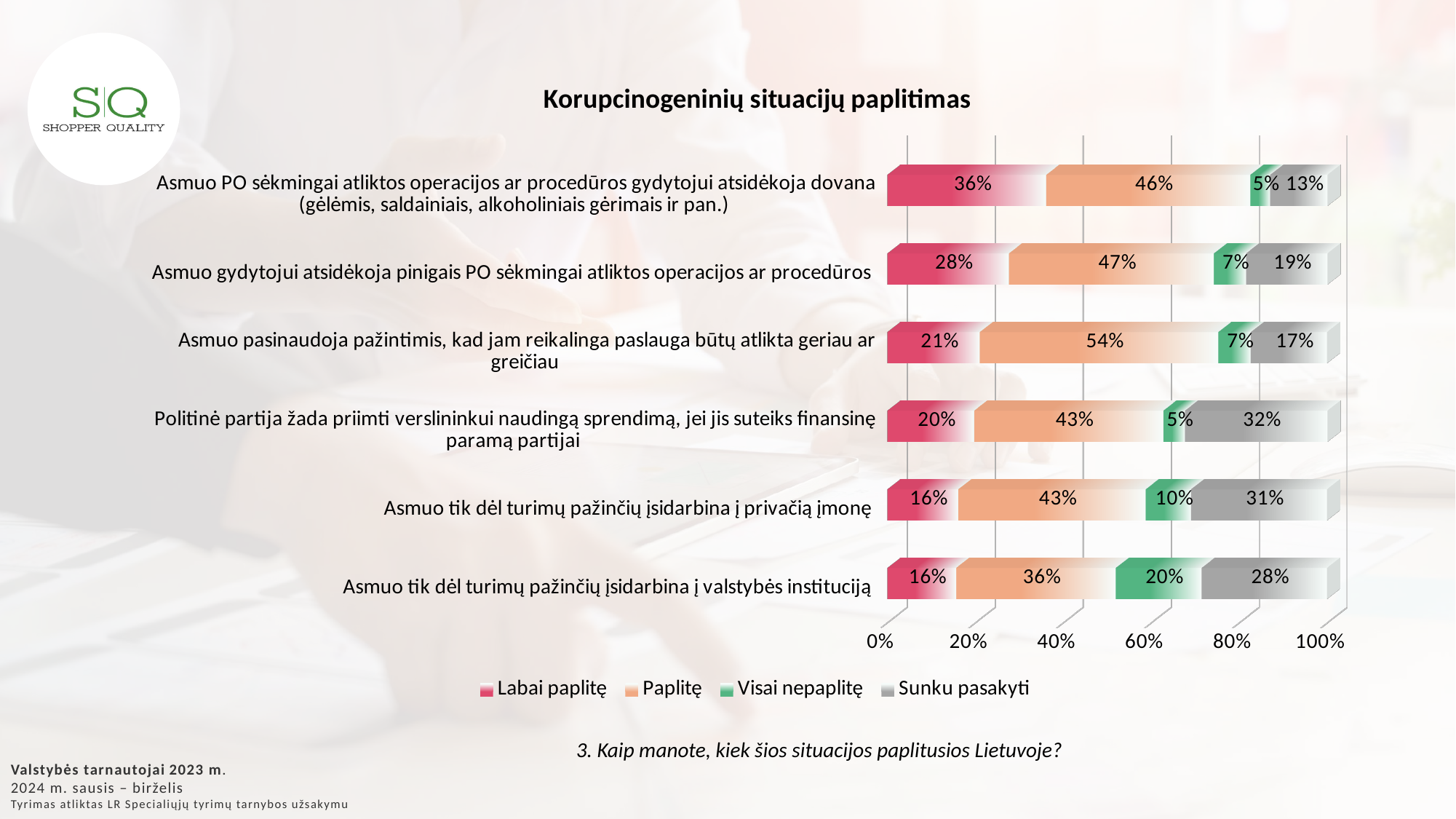
What is the combined total of 'Labai paplitę' and 'Paplitę' for 'Asmuo gydytojui atsidėkoja pinigais PO sėkmingai atliktos operacijos ar procedūros'? 75% What is the 'Sunku pasakyti' value for 'Politinė partija žada priimti verslininkui naudingą sprendimą, jei jis suteiks finansinę paramą partijai'? 32% How many series does the legend list? 4 Which category has the highest 'Visai nepaplitę' value? Asmuo tik dėl turimų pažinčių įsidarbina į valstybės instituciją What is the 'Labai paplitę' value for 'Asmuo PO sėkmingai atliktos operacijos ar procedūros gydytojui atsidėkoja dovana (gėlėmis, saldainiais, alkoholiniais gėrimais ir pan.)'? 36% What is the difference between the 'Labai paplitę' values for 'Asmuo gydytojui atsidėkoja pinigais PO sėkmingai atliktos operacijos ar procedūros' and 'Asmuo tik dėl turimų pažinčių įsidarbina į privačią įmonę'? 12% What is the 'Paplitę' value for 'Asmuo pasinaudoja pažintimis, kad jam reikalinga paslauga būtų atlikta geriau ar greičiau'? 54% How many categories (situations) are shown in the chart? 6 What type of chart is shown on the slide? Stacked bar chart Which category has the lowest 'Sunku pasakyti' value? Asmuo PO sėkmingai atliktos operacijos ar procedūros gydytojui atsidėkoja dovana (gėlėmis, saldainiais, alkoholiniais gėrimais ir pan.) Which is larger: the 'Visai nepaplitę' value for 'Asmuo tik dėl turimų pažinčių įsidarbina į privačią įmonę' or for 'Asmuo tik dėl turimų pažinčių įsidarbina į valstybės instituciją'? Asmuo tik dėl turimų pažinčių įsidarbina į valstybės instituciją What is the title of the chart? Korupcinogeninių situacijų paplitimas